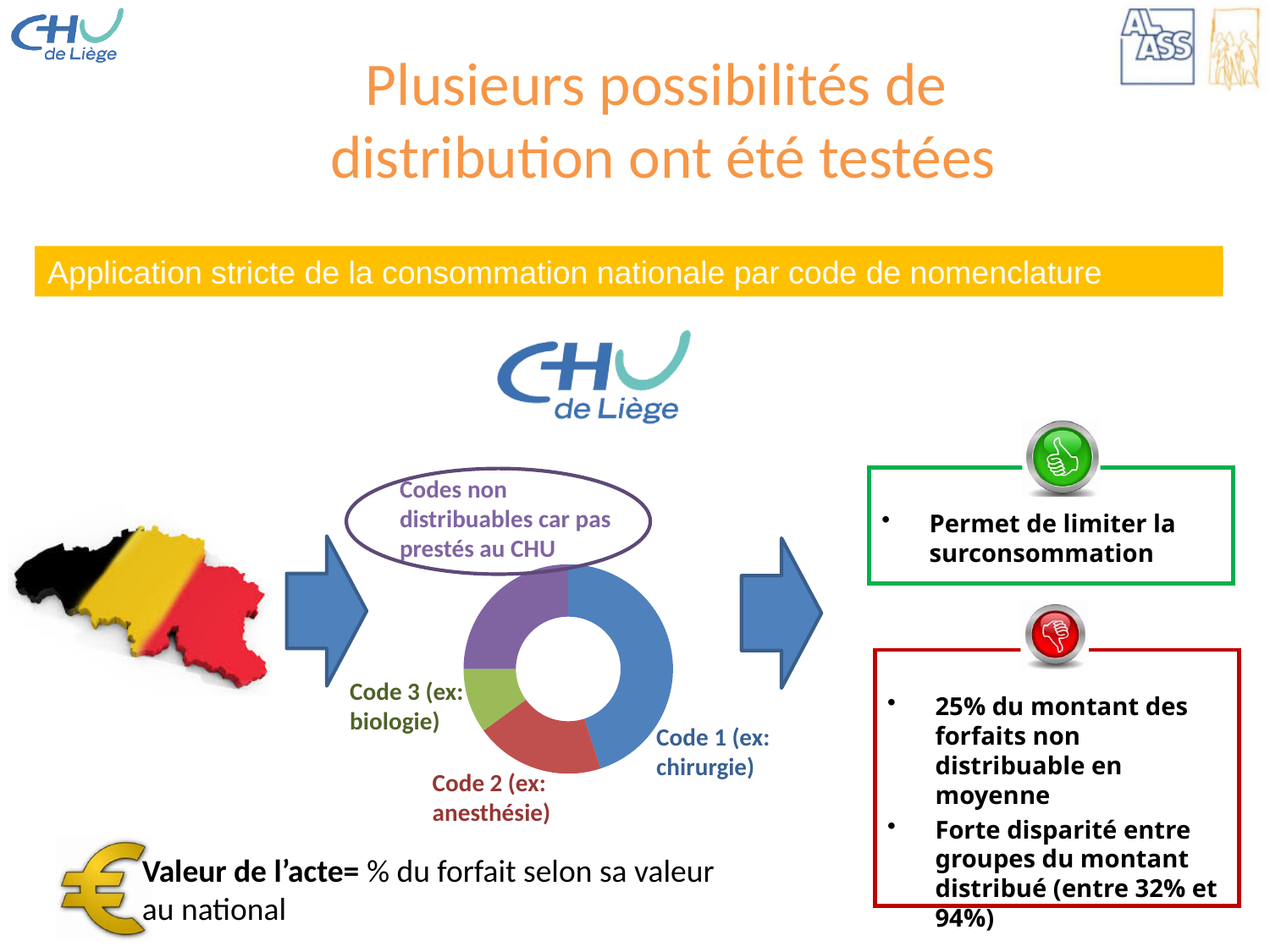
Which is larger in the donut chart: Code 1 (ex: chirurgie) or Code 2 (ex: anesthésie)? Code 1 (ex: chirurgie) Which is larger in the donut chart: Code 1 (ex: chirurgie) or the 'Codes non distribuables car pas prestés au CHU' segment? Code 1 (ex: chirurgie) Which is larger in the donut chart: the 'Codes non distribuables car pas prestés au CHU' segment or Code 3 (ex: biologie)? Codes non distribuables car pas prestés au CHU How many segments does the donut chart have? 4 Which segment of the donut chart is the largest? Code 1 (ex: chirurgie) What colour is the segment labelled 'Codes non distribuables car pas prestés au CHU'? Purple What kind of chart is shown on the slide? Donut (pie) chart Which segment of the donut chart is the smallest? Code 3 (ex: biologie) What colour is the Code 1 (ex: chirurgie) segment of the donut chart? Blue